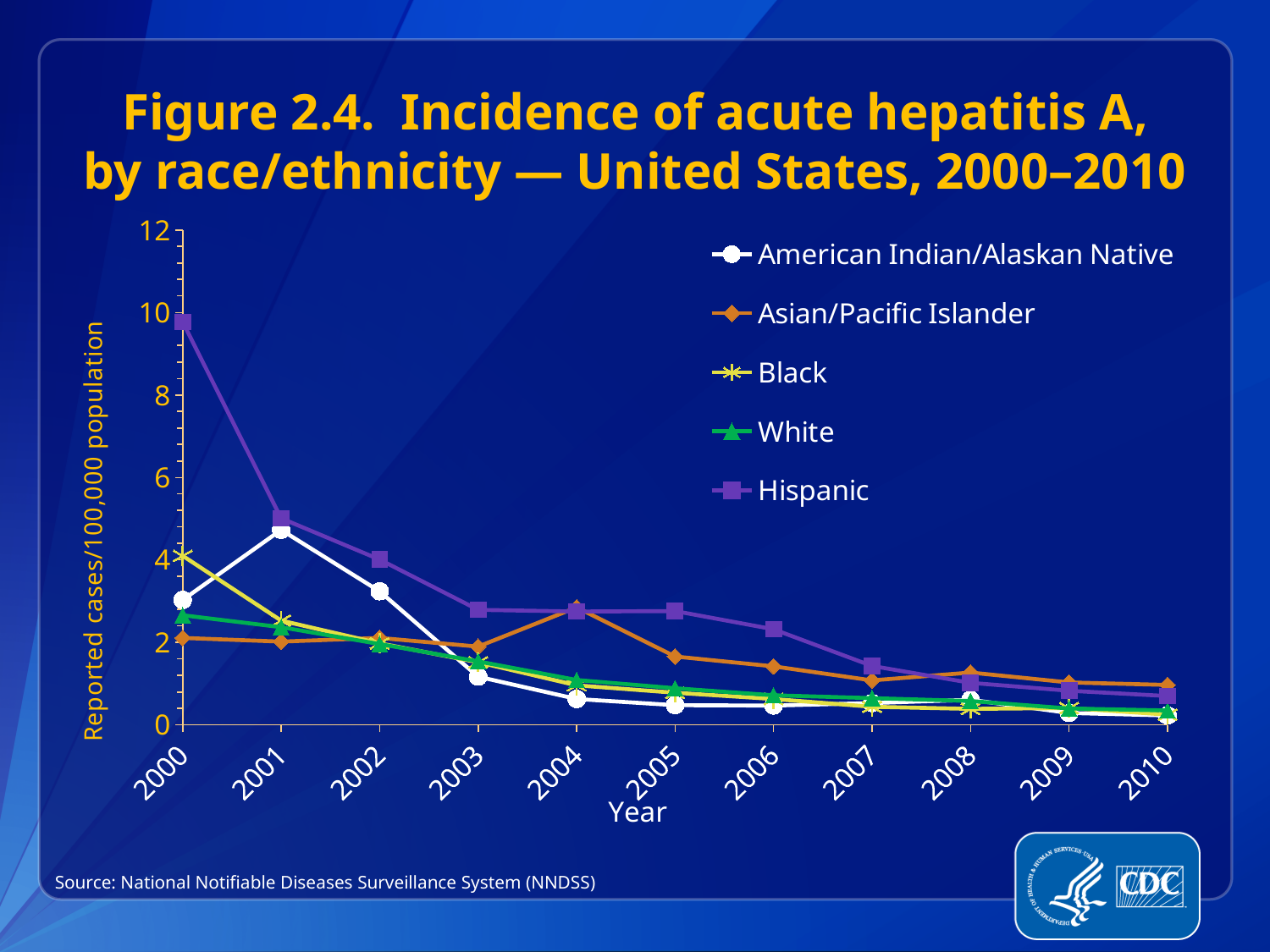
In 2001, which is larger: the value for American Indian/Alaskan Native or the value for Black? American Indian/Alaskan Native Which race/ethnicity group had the highest incidence in 2000? Hispanic What is the title of the y axis? Reported cases/100,000 population Is the value for American Indian/Alaskan Native in 2004 greater or less than 2? less Is the value for Hispanic in 2001 greater or less than 4? greater Is the value for Hispanic in 2000 greater or less than 8? greater Does the Hispanic line rise or fall from 2000 to 2010? fall How many years are plotted along the x axis? 11 What kind of chart is shown on the slide? line chart Which race/ethnicity group had the highest incidence in 2006? Hispanic How many series does the legend list? 5